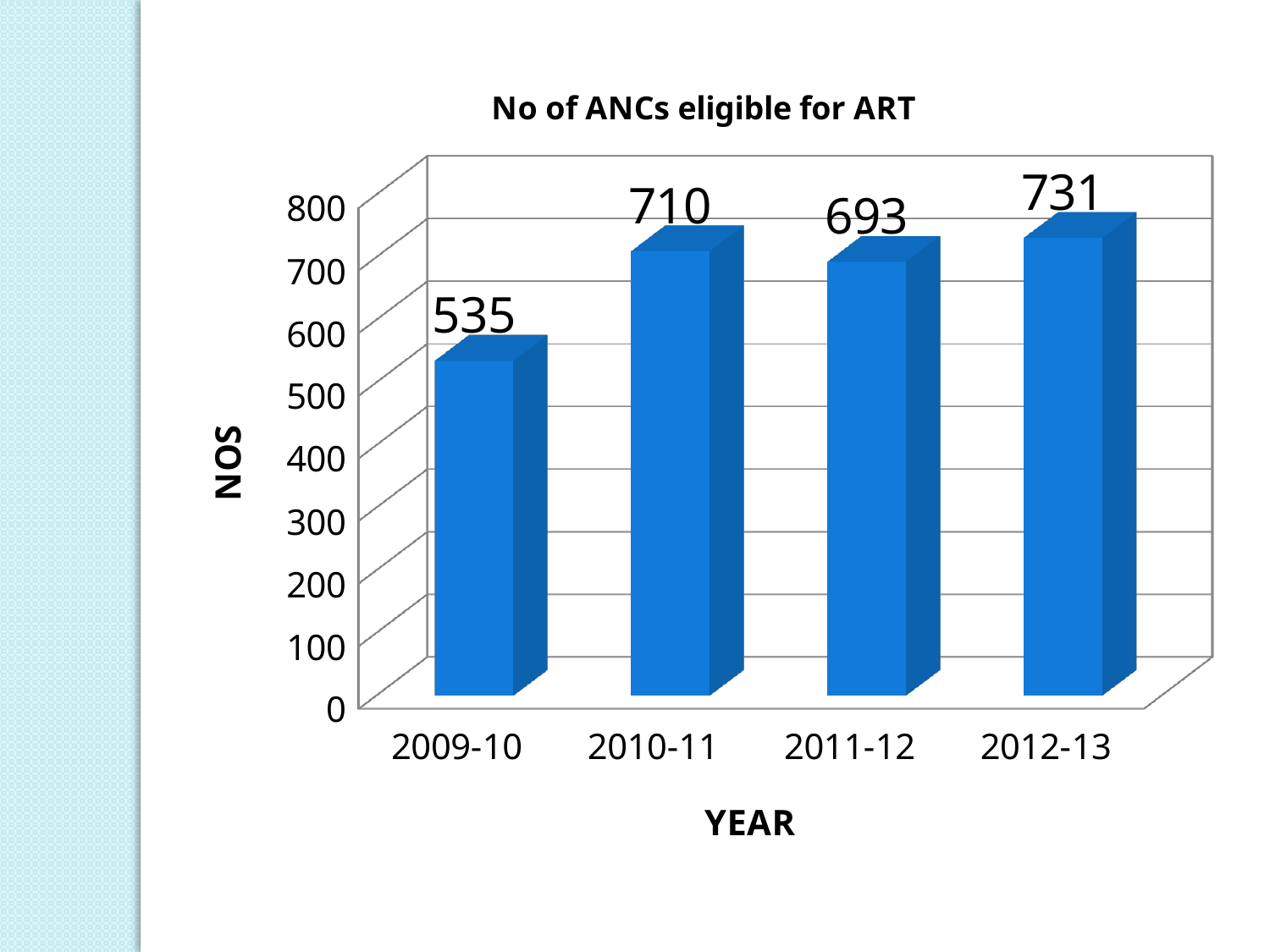
What is the title of the chart? No of ANCs eligible for ART What is the difference between the values for 2010-11 and 2009-10? 175 What is the difference between the values for 2012-13 and 2011-12? 38 Is the value for 2009-10 greater or less than 600? less Which year has the lowest number of ANCs eligible for ART? 2009-10 What kind of chart is shown on the slide? bar chart Which is larger, the value for 2010-11 or the value for 2011-12? 2010-11 Which year has the highest number of ANCs eligible for ART? 2012-13 What is the number of ANCs eligible for ART in 2012-13? 731 What is the number of ANCs eligible for ART in 2011-12? 693 How many years are shown on the x axis? 4 What is the number of ANCs eligible for ART in 2009-10? 535